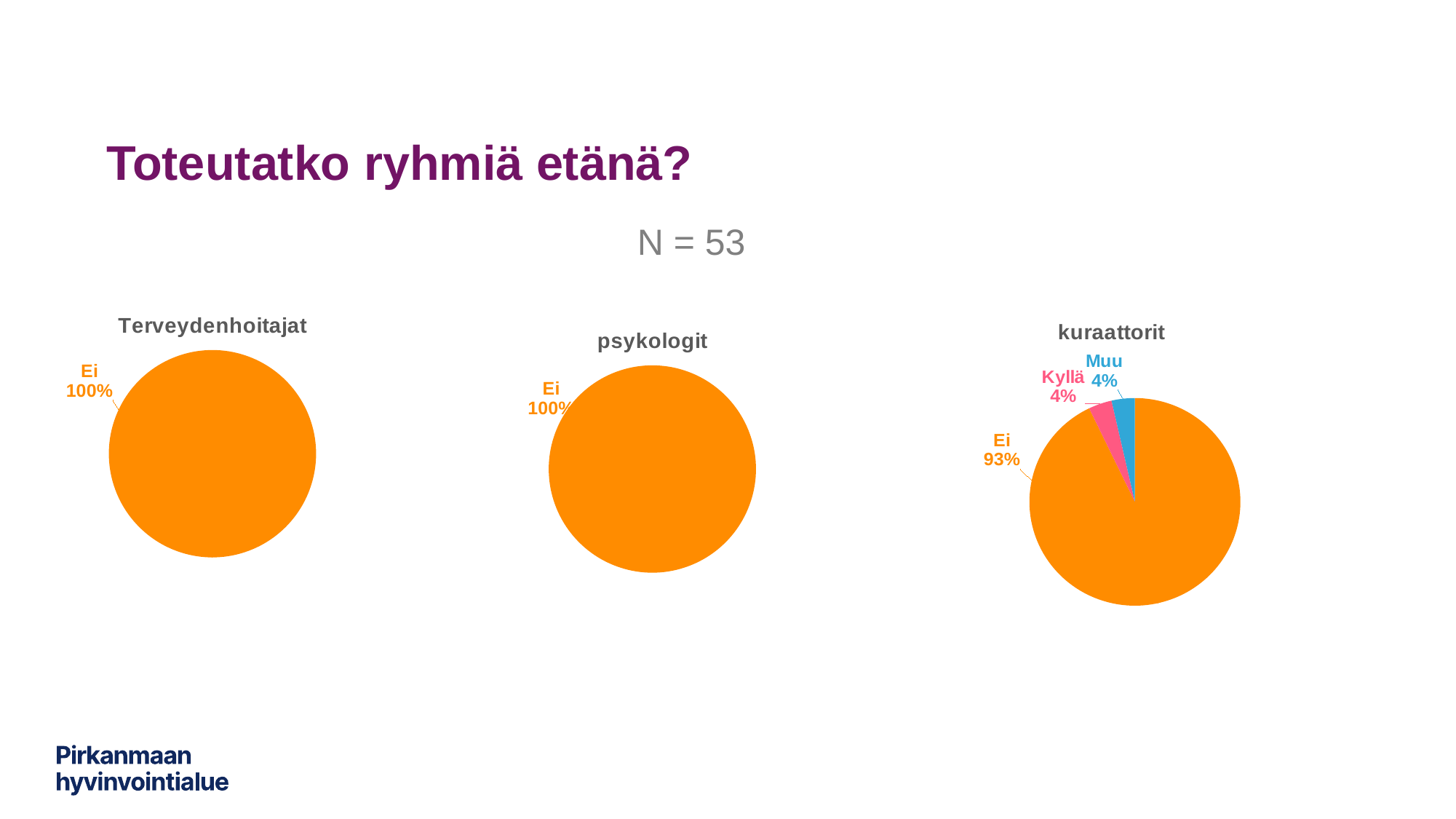
In the kuraattorit chart, which slice is the largest? Ei In the kuraattorit chart, which is larger, the Ei slice or the Muu slice? Ei In the kuraattorit chart, what is the difference between the Ei share and the Kyllä share? 89% What kind of chart is the Terveydenhoitajat chart? Pie chart How many charts are shown on the slide? 3 In the kuraattorit chart, how many slices are there? 3 In the Terveydenhoitajat chart, what share does the Ei slice have? 100% What is the title of the chart on the right of the slide? kuraattorit In the kuraattorit chart, what share does the Ei slice have? 93% In the kuraattorit chart, what share does the Kyllä slice have? 4% In the psykologit chart, what share does the Ei slice have? 100% In the kuraattorit chart, what share does the Muu slice have? 4%